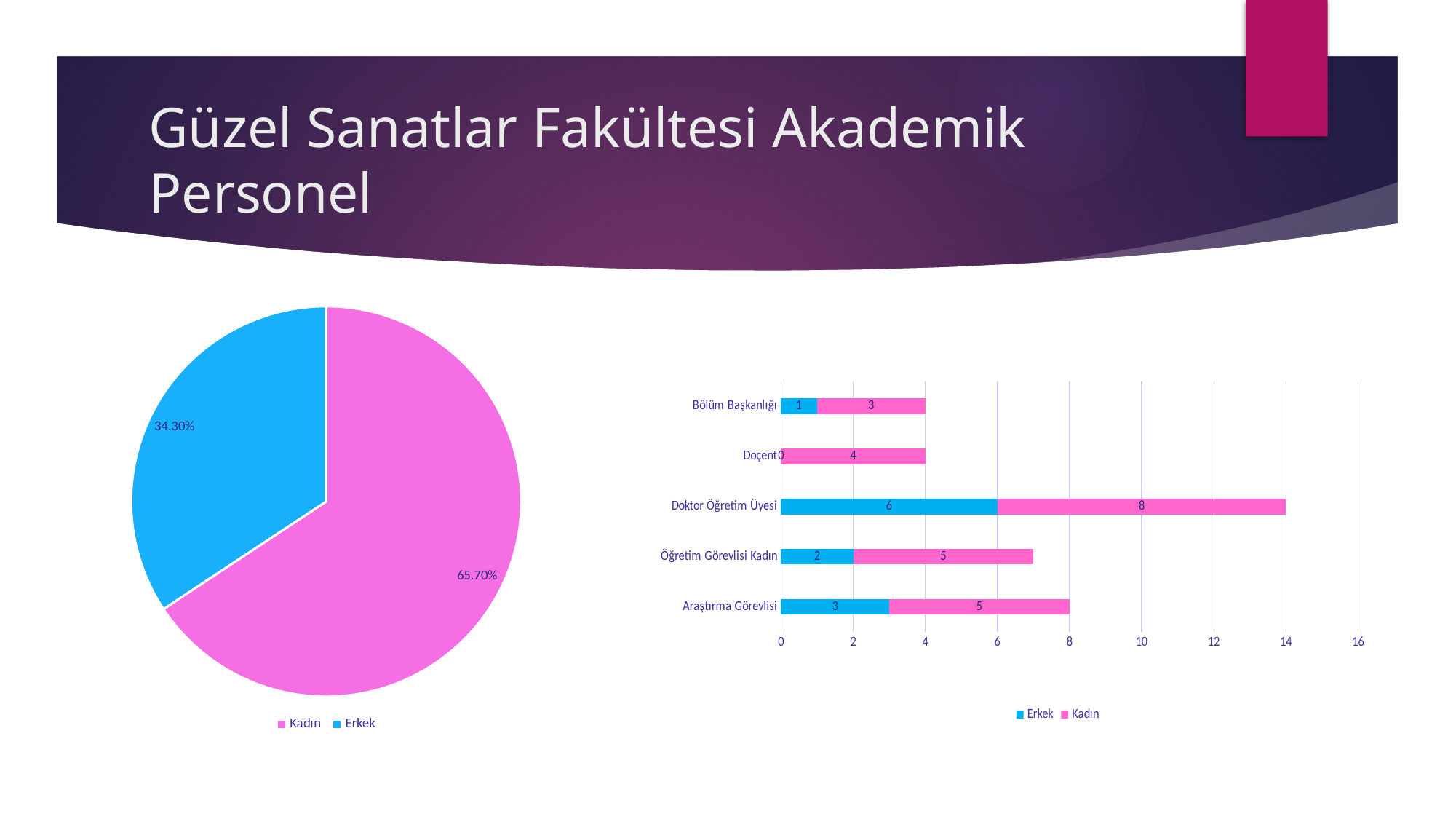
In the bar chart on the right, what is the total of the stacked bar for Doktor Öğretim Üyesi? 14 How many categories are shown in the bar chart on the right? 5 In the bar chart on the right, what is the Kadın value for Doktor Öğretim Üyesi? 8 In the pie chart on the left, what share does Kadın have? 65.70% In the bar chart on the right, what is the total of the stacked bar for Öğretim Görevlisi Kadın? 7 In the bar chart on the right, what is the Erkek value for Araştırma Görevlisi? 3 In the pie chart on the left, what share does Erkek have? 34.30% In the bar chart on the right, what is the Erkek value for Doçent? 0 What kind of chart is the chart on the left of the slide? pie chart What kind of chart is the chart on the right of the slide? bar chart In the bar chart on the right, which category has the highest Kadın value? Doktor Öğretim Üyesi In the bar chart on the right, what is the difference between the Kadın and Erkek values for Bölüm Başkanlığı? 2